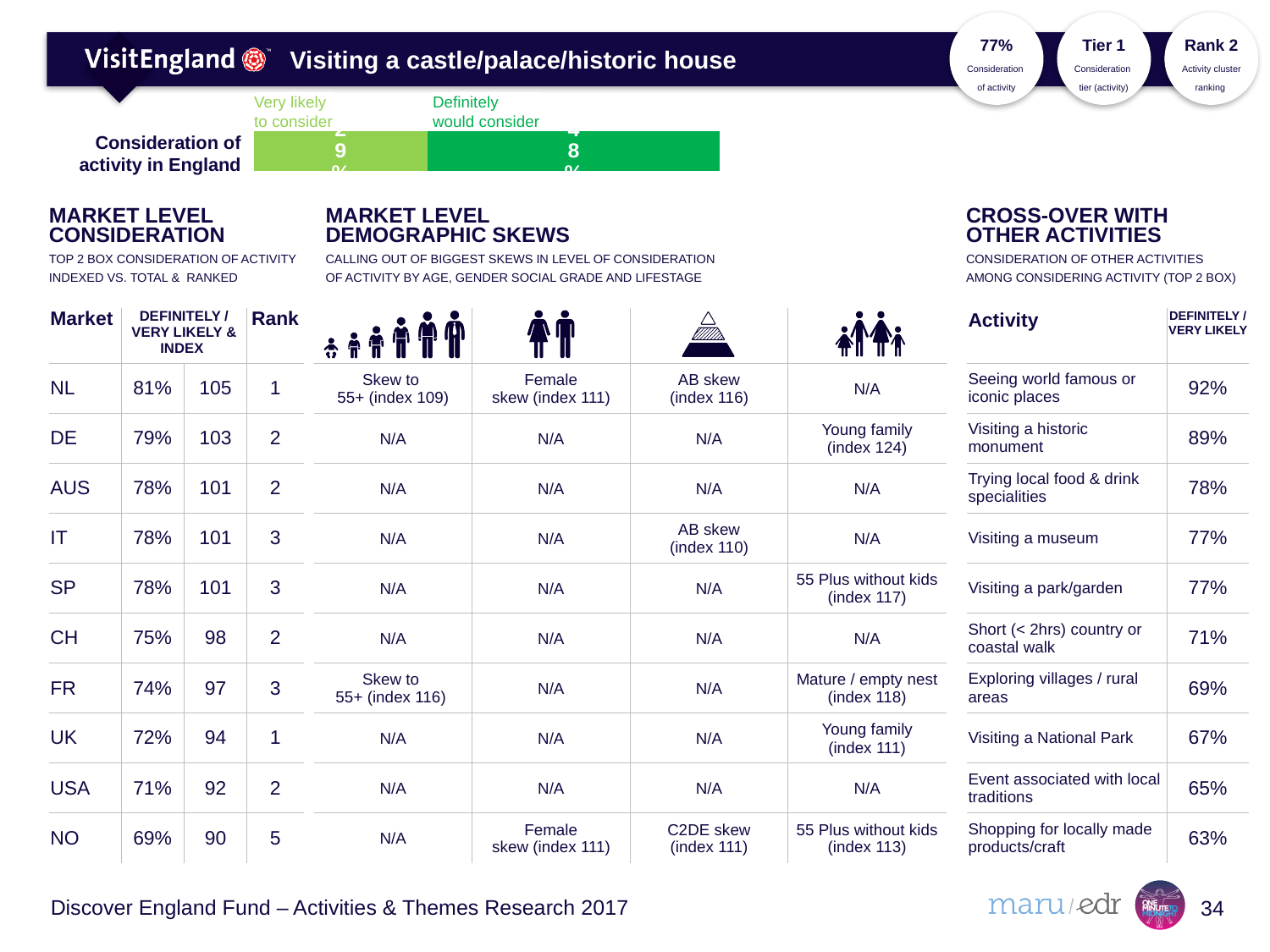
In the 'Consideration of activity in England' chart, which segment is larger: 'Very likely to consider' or 'Definitely would consider'? Definitely would consider In the 'Consideration of activity in England' chart, what is the value for 'Definitely would consider'? 48% What is the total of the stacked bar in the 'Consideration of activity in England' chart? 77% What kind of chart is used for 'Consideration of activity in England'? bar chart In the 'Consideration of activity in England' chart, what is the difference between 'Definitely would consider' and 'Very likely to consider'? 19% In the 'Consideration of activity in England' chart, what is the value for 'Very likely to consider'? 29% In the 'Consideration of activity in England' chart, which colour represents 'Definitely would consider'? dark green How many bars does the 'Consideration of activity in England' chart show? 1 How many series does the legend of the 'Consideration of activity in England' chart list? 2 What are the two legend entries of the 'Consideration of activity in England' chart? Very likely to consider; Definitely would consider